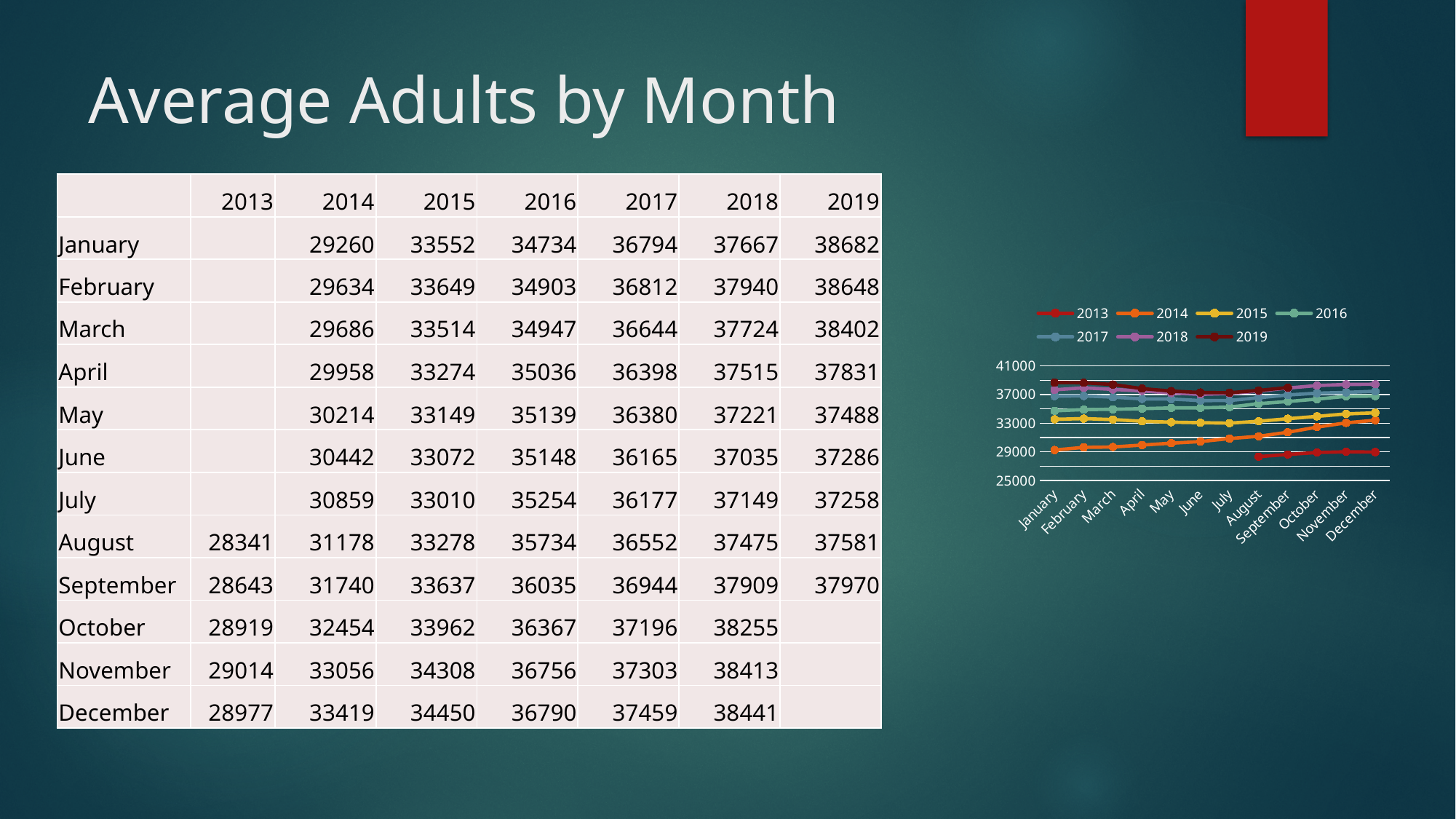
What is the difference between the January values for 2019 and 2018? 1015 How many series does the chart's legend list? 7 Which year has the lowest values overall on the chart? 2013 Is the value for 2013 in August greater or less than 29000? less What is the average adults value for January 2019? 38682 What colour is the 2014 series in the chart's legend? orange Does the 2014 line rise or fall from January to December? rise Which year has the highest value in January? 2019 How many months are shown along the x axis of the chart? 12 Is the value for 2018 in December greater or less than 37000? greater In July, which is larger: the value for 2016 or the value for 2015? 2016 What kind of chart is shown on the right of the slide? line chart